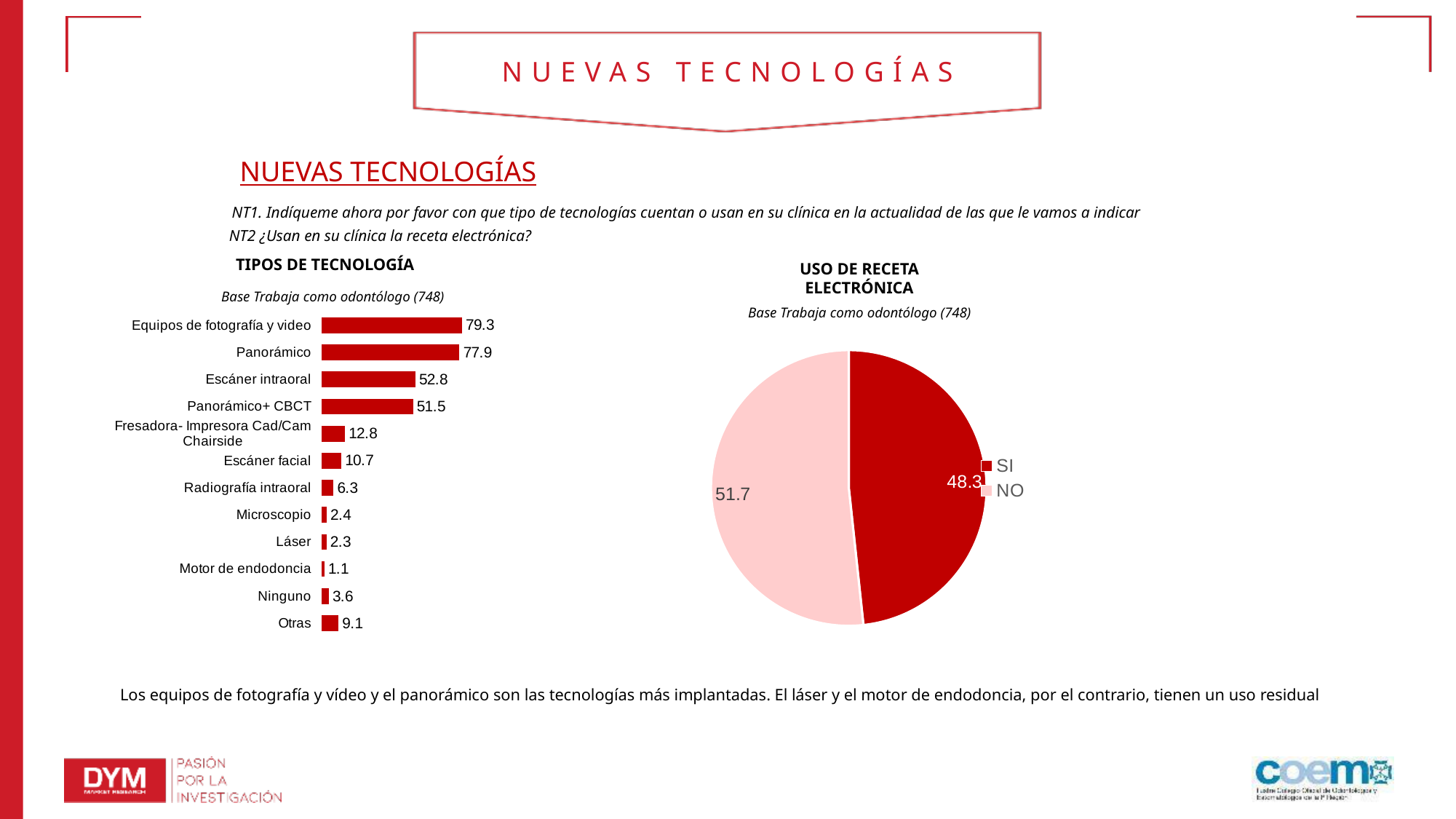
In the 'TIPOS DE TECNOLOGÍA' chart, what is the difference between Equipos de fotografía y video and Panorámico? 1.4 In the 'TIPOS DE TECNOLOGÍA' chart, which category has the highest value? Equipos de fotografía y video In the 'TIPOS DE TECNOLOGÍA' chart, what is the value for Escáner intraoral? 52.8 What kind of chart is 'TIPOS DE TECNOLOGÍA'? Bar chart In the 'USO DE RECETA ELECTRÓNICA' chart, what is the value for SI? 48.3 How many entries does the legend of the 'USO DE RECETA ELECTRÓNICA' chart list? 2 What kind of chart is 'USO DE RECETA ELECTRÓNICA'? Pie chart In the 'USO DE RECETA ELECTRÓNICA' chart, which slice is larger: SI or NO? NO How many categories are shown in the 'TIPOS DE TECNOLOGÍA' chart? 12 In the 'TIPOS DE TECNOLOGÍA' chart, what is the value for Fresadora- Impresora Cad/Cam Chairside? 12.8 In the 'TIPOS DE TECNOLOGÍA' chart, which category has the lowest value? Motor de endodoncia In the 'TIPOS DE TECNOLOGÍA' chart, which is larger: Escáner facial or Radiografía intraoral? Escáner facial